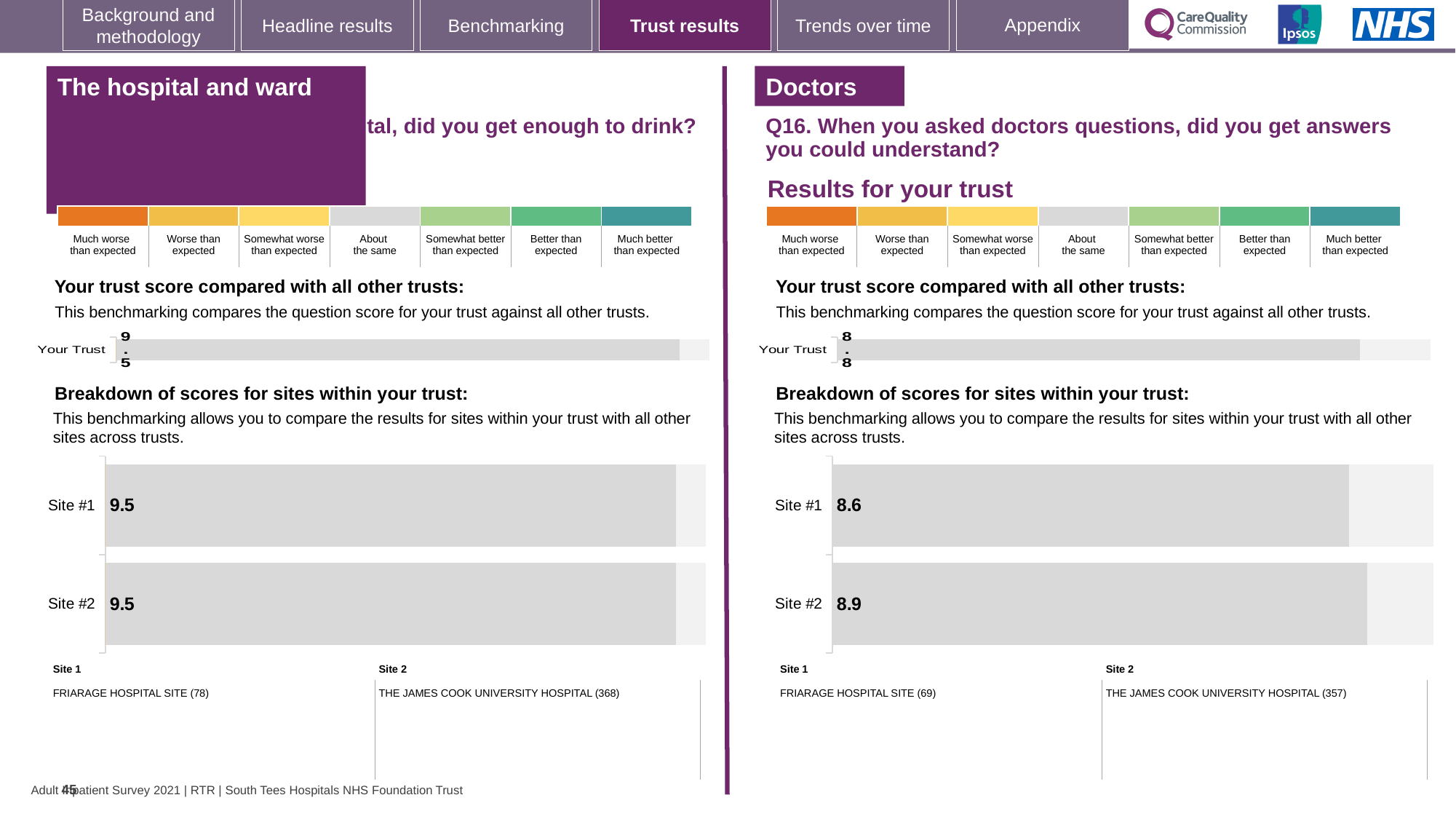
On the left-hand (The hospital and ward) 'Your trust score compared with all other trusts' chart, what is the score for Your Trust? 9.5 On the right-hand (Doctors, Q16) site breakdown chart, which site has the lower score? Site #1 On the left-hand (The hospital and ward) site breakdown chart, what is the difference between the Site #1 and Site #2 scores? 0 What kind of chart is used for the 'Breakdown of scores for sites within your trust' on the left-hand side of the slide? Bar chart On the right-hand (Doctors, Q16) 'Breakdown of scores for sites within your trust' chart, what is the score for Site #1? 8.6 On the right-hand (Doctors, Q16) site breakdown chart, which hospital is Site 2 according to the key below the chart? THE JAMES COOK UNIVERSITY HOSPITAL (357) On the right-hand (Doctors, Q16) site breakdown chart, which site has the higher score? Site #2 How many sites are shown on the right-hand (Doctors, Q16) 'Breakdown of scores for sites within your trust' chart? 2 On the right-hand (Doctors, Q16) 'Breakdown of scores for sites within your trust' chart, what is the score for Site #2? 8.9 On the left-hand (The hospital and ward) 'Breakdown of scores for sites within your trust' chart, what is the score for Site #2? 9.5 On the right-hand (Doctors, Q16) 'Your trust score compared with all other trusts' chart, what is the score for Your Trust? 8.8 On the right-hand (Doctors, Q16) site breakdown chart, what is the difference between the Site #2 and Site #1 scores? 0.3